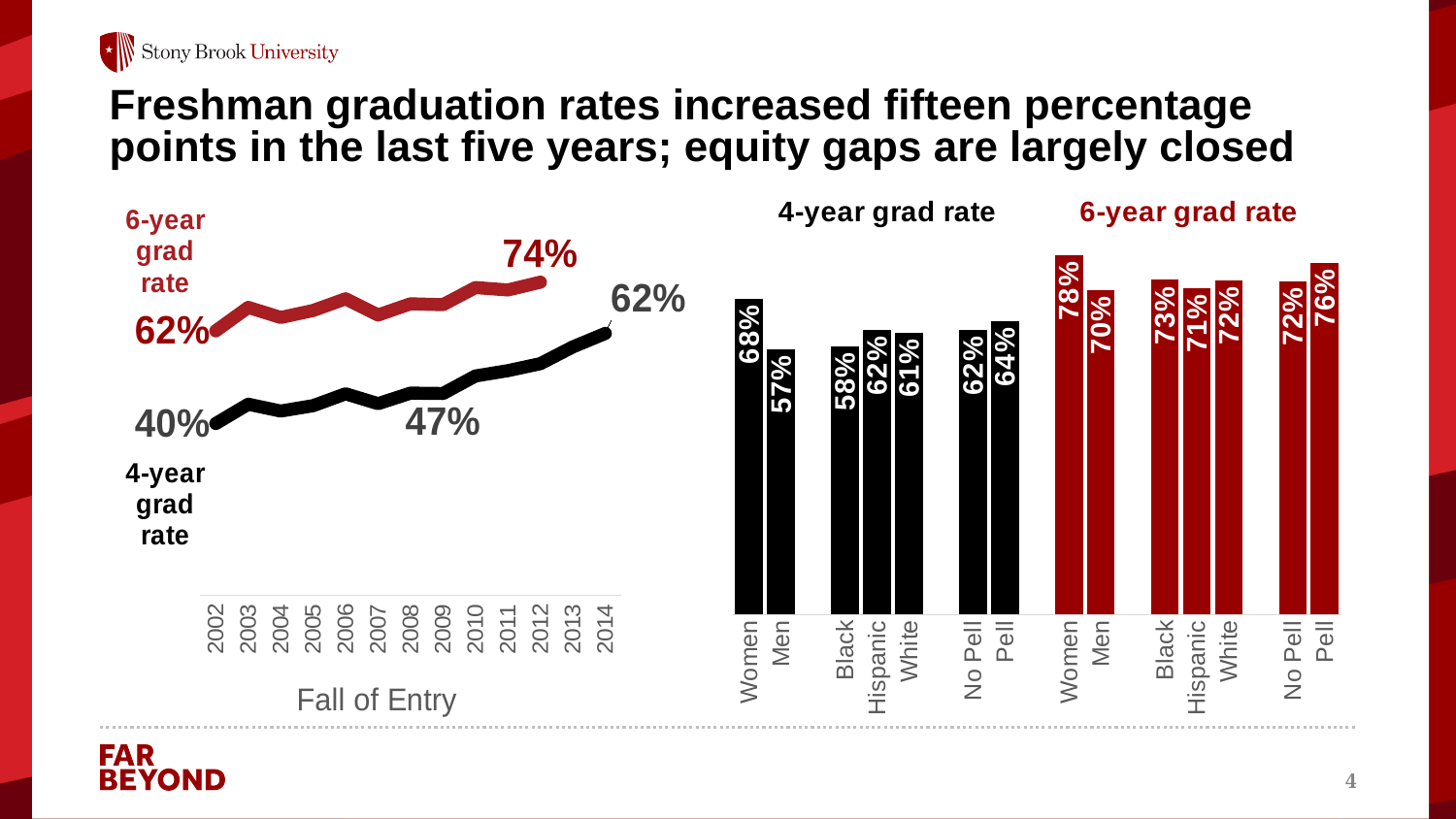
In the bar chart on the right, which group has the highest 6-year grad rate? Women In the bar chart on the right, what is the difference between the 4-year grad rates of Women and Men? 11 percentage points In the bar chart on the right, which has the higher 6-year grad rate, Pell or No Pell? Pell What kind of chart is the chart on the right of the slide? Bar chart In the bar chart on the right, what is the 4-year grad rate for Women? 68% In the line chart on the left, what is the title of the x axis? Fall of Entry In the line chart on the left, what is the 4-year grad rate labelled at the start of the black line? 40% In the bar chart on the right, how many groups are shown for the 4-year grad rate? 7 In the bar chart on the right, which group has the lowest 4-year grad rate? Men In the bar chart on the right, what is the 6-year grad rate for Pell students? 76% In the line chart on the left, does the 4-year grad rate rise or fall across the years of entry? Rise In the line chart on the left, what is the 6-year grad rate labelled at the end of the red line? 74%